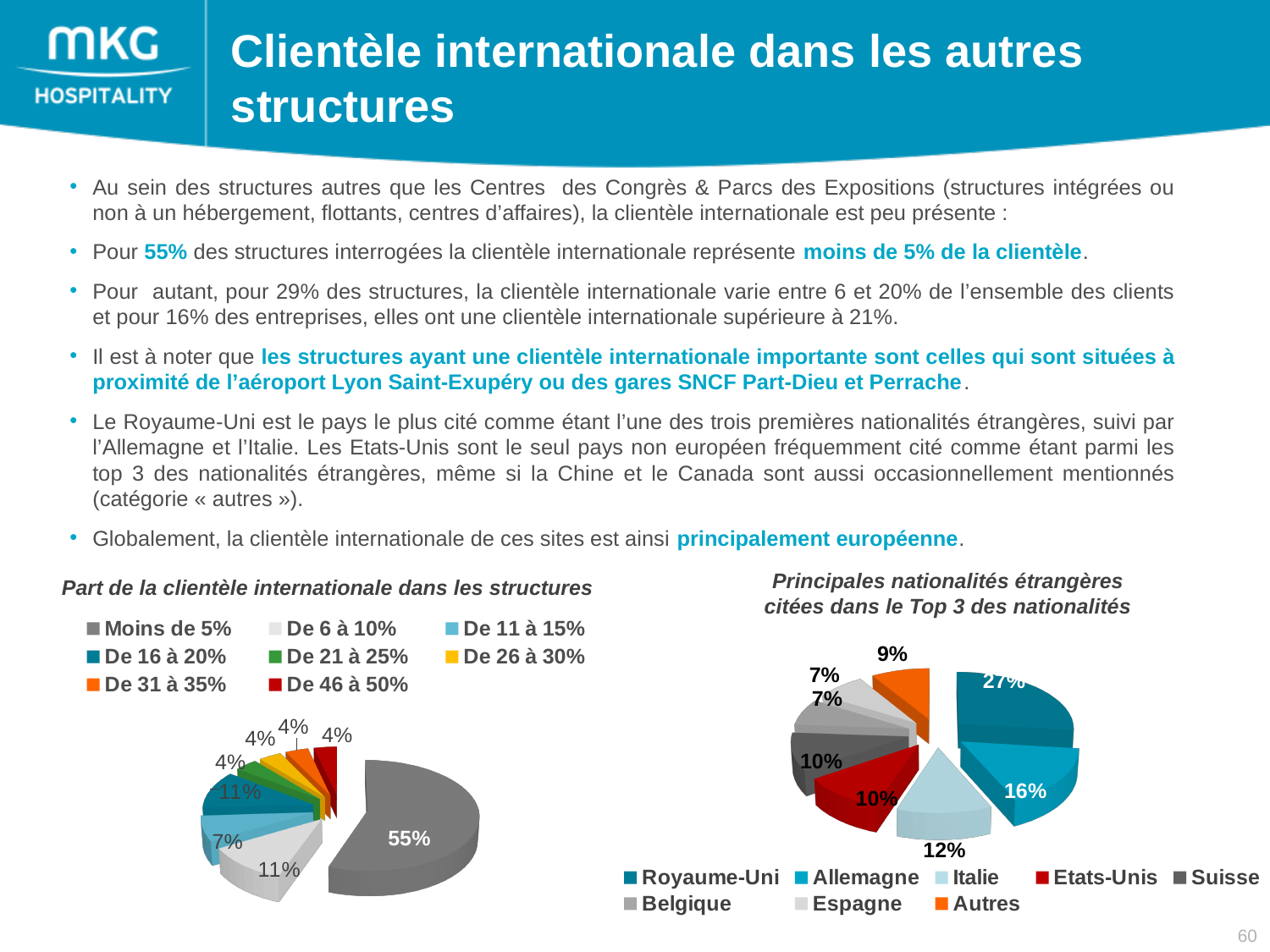
In the chart 'Part de la clientèle internationale dans les structures', which category has the largest slice? Moins de 5% What type of chart is 'Part de la clientèle internationale dans les structures'? Pie chart How many nationalities does the legend of the chart 'Principales nationalités étrangères citées dans le Top 3 des nationalités' list? 8 In the chart 'Principales nationalités étrangères citées dans le Top 3 des nationalités', what is the value for Allemagne? 16% In the chart 'Principales nationalités étrangères citées dans le Top 3 des nationalités', which nationality has the largest slice? Royaume-Uni In the chart 'Principales nationalités étrangères citées dans le Top 3 des nationalités', what is the value for Royaume-Uni? 27% In the chart 'Part de la clientèle internationale dans les structures', what is the value for 'De 11 à 15%'? 7% In the chart 'Principales nationalités étrangères citées dans le Top 3 des nationalités', what is the value for Autres? 9% In the chart 'Principales nationalités étrangères citées dans le Top 3 des nationalités', which is larger, Italie or Etats-Unis? Italie How many categories does the legend of the chart 'Part de la clientèle internationale dans les structures' list? 8 In the chart 'Principales nationalités étrangères citées dans le Top 3 des nationalités', what is the difference between the values for Royaume-Uni and Allemagne? 11% In the chart 'Part de la clientèle internationale dans les structures', what share of structures have less than 5% international clientele ('Moins de 5%')? 55%